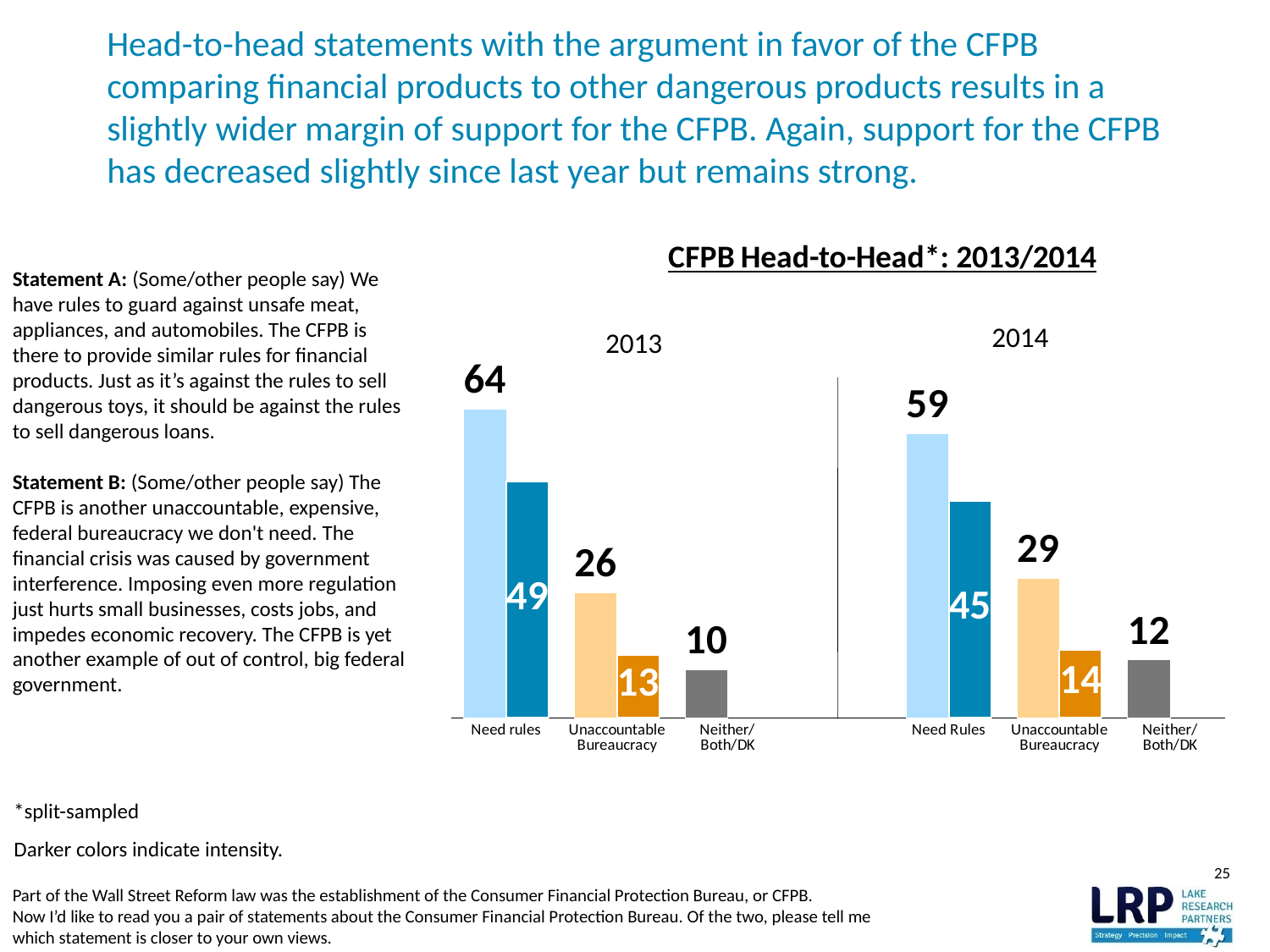
Which category has the lowest value in 2013? Neither/Both/DK What is the darker (intensity) value for Need Rules in 2014? 45 What is the value for Need Rules in 2014? 59 What is the darker (intensity) value for Unaccountable Bureaucracy in 2013? 13 What is the value for Unaccountable Bureaucracy in 2014? 29 What kind of chart is shown on the slide? Bar chart Which is larger, the Unaccountable Bureaucracy value in 2013 or in 2014? 2014 Which category has the highest value in 2014? Need Rules What is the title of the chart? CFPB Head-to-Head*: 2013/2014 What is the difference between the Need rules value in 2013 and the Need Rules value in 2014? 5 What is the value for Need rules in 2013? 64 What is the value for Neither/Both/DK in 2013? 10